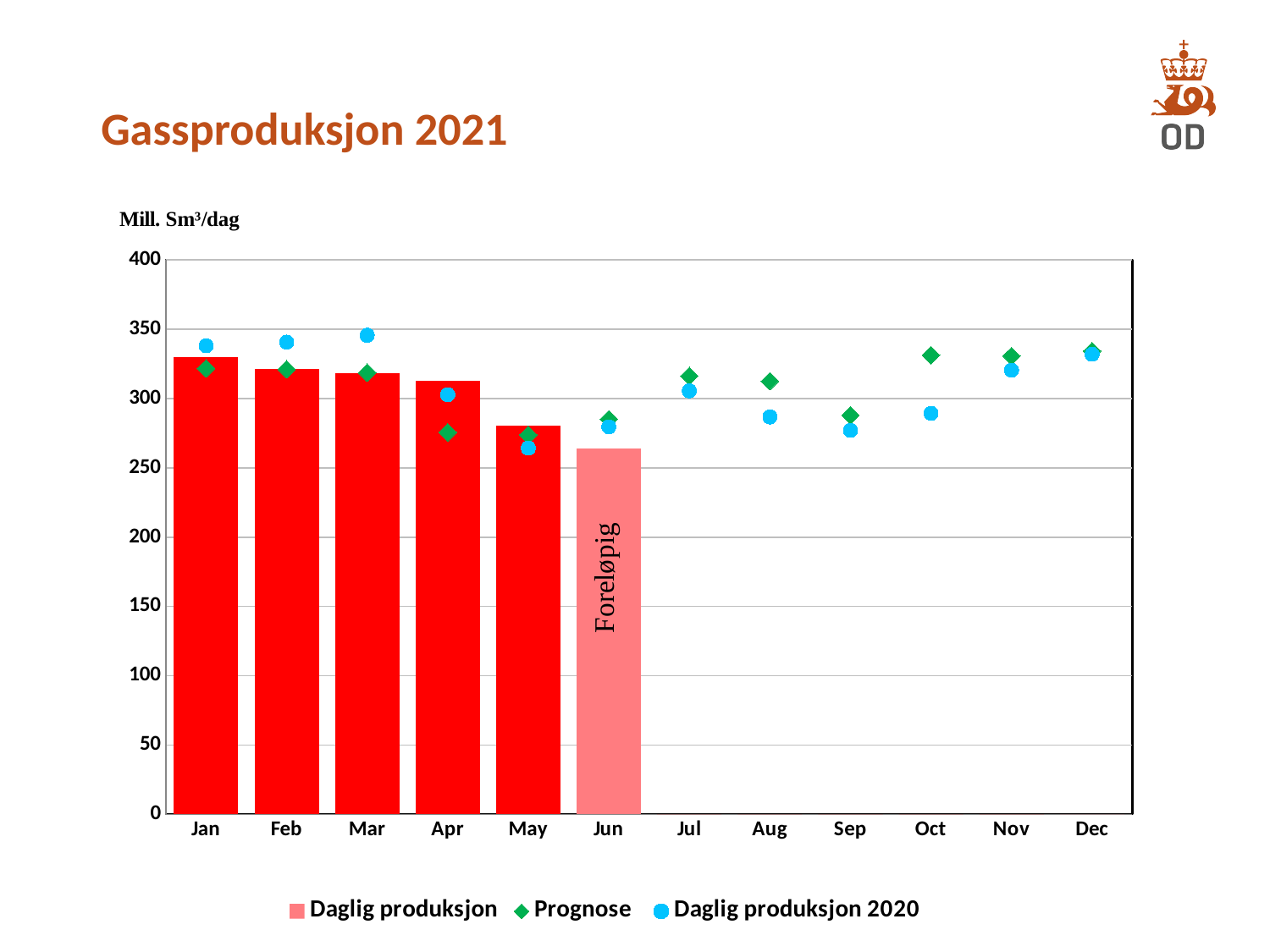
How many months are shown on the x axis? 12 Is the Daglig produksjon value for Jun greater or less than 250? greater Is the Daglig produksjon value for May greater or less than 300? less Is the Prognose value for Sep greater or less than 300? less What kind of chart is shown on the slide? Bar chart Do the Daglig produksjon bars rise or fall from Jan to Jun? Fall Which month has the lowest Daglig produksjon 2020 value? May Which month has the highest Daglig produksjon bar? Jan How many series does the legend list? 3 Which is larger in Oct, the Prognose value or the Daglig produksjon 2020 value? Prognose Which month has the lowest Daglig produksjon bar? Jun What label is written on the Jun bar? Foreløpig